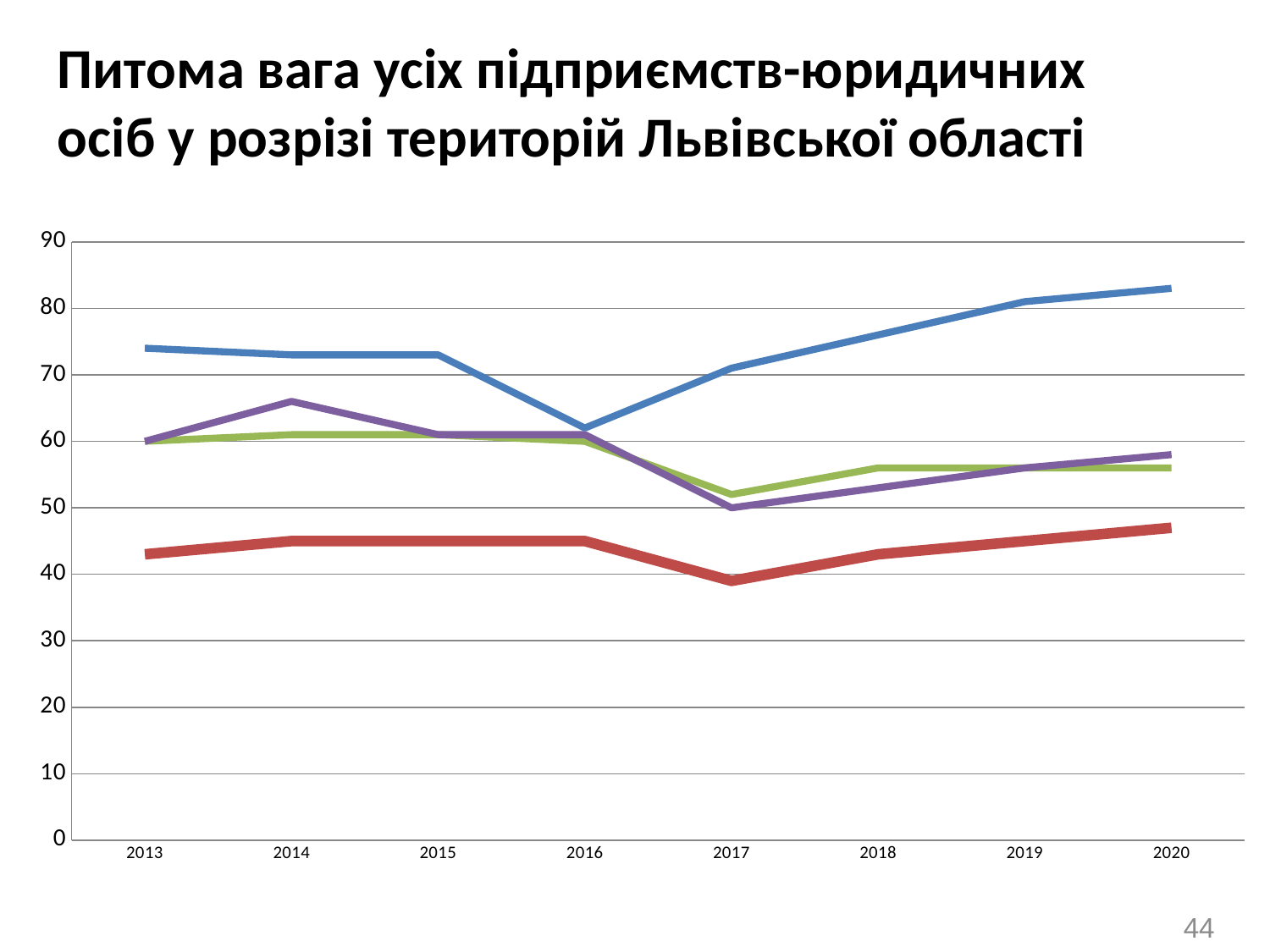
Is the value of the blue line in 2016 greater or less than 70? less Does the blue line rise or fall from 2016 to 2020? rise How many years are plotted along the x axis? 8 Is the value of the purple line in 2014 greater or less than 60? greater What is the title of the chart? Питома вага усіх підприємств-юридичних осіб у розрізі територій Львівської області Is the value of the red line in 2017 greater or less than 50? less In which year does the blue line reach its highest value? 2020 In which year does the blue line reach its lowest value? 2016 In which year does the red line reach its lowest value? 2017 In 2013, which line has the larger value, the blue line or the red line? blue What kind of chart is shown on the slide? line chart